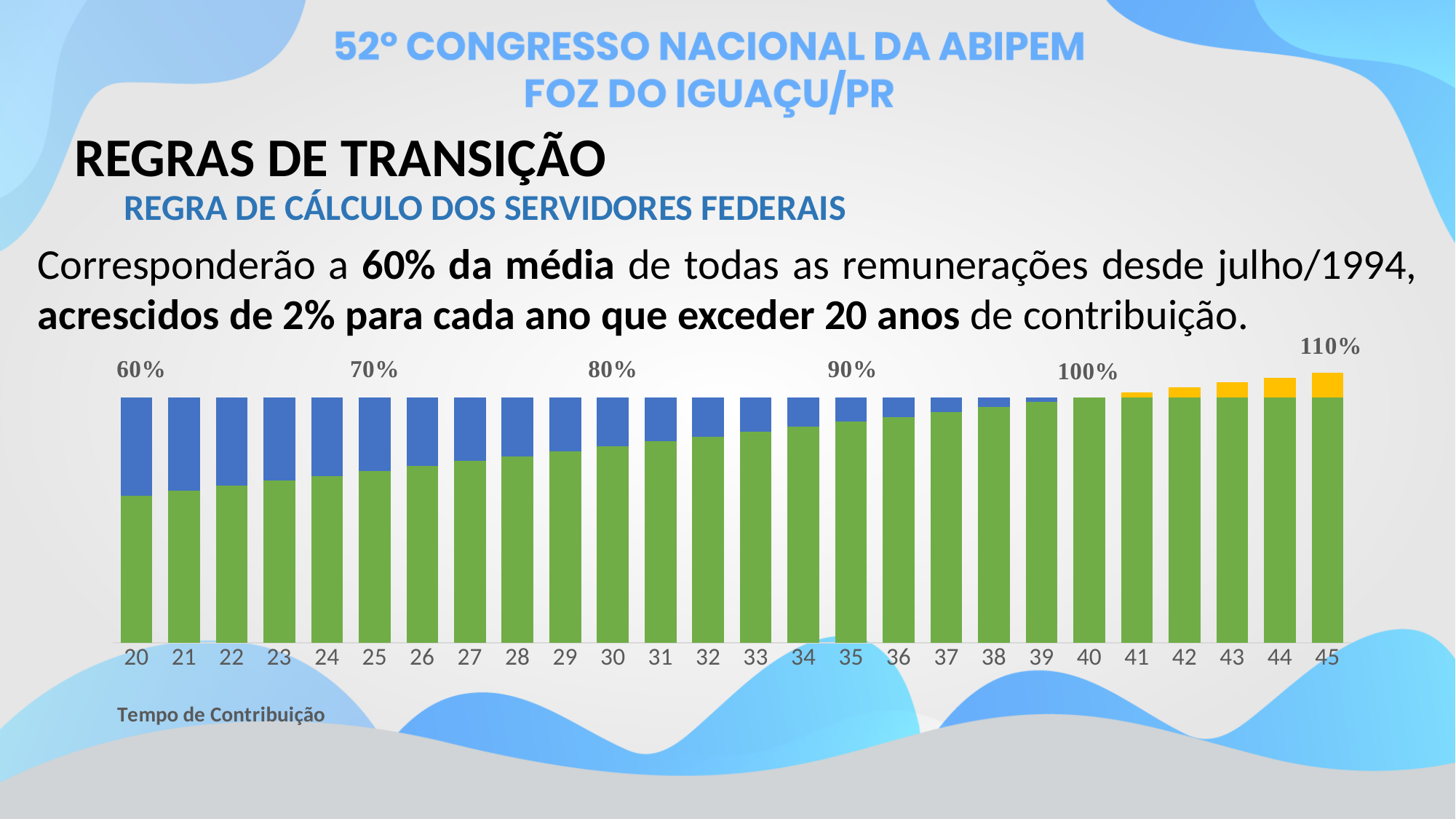
What value is labelled above the bar for 20 years of contribution? 60% What value is labelled above the bar for 40 years of contribution? 100% What is the x-axis title of the chart? Tempo de Contribuição What value is labelled above the bar for 30 years of contribution? 80% What kind of chart is shown on the slide? bar chart Which has the larger labelled value, 25 years or 35 years of contribution? 35 years Do the green bars rise or fall as contribution time increases from 20 to 45 years? rise Which contribution time has the lowest green bar? 20 How many contribution-time categories are shown on the x axis of the chart? 26 What value is labelled above the bar for 45 years of contribution? 110% What is the difference between the labelled values for 45 and 20 years of contribution? 50% Which contribution time has the highest green bar? 40 to 45 (tied)